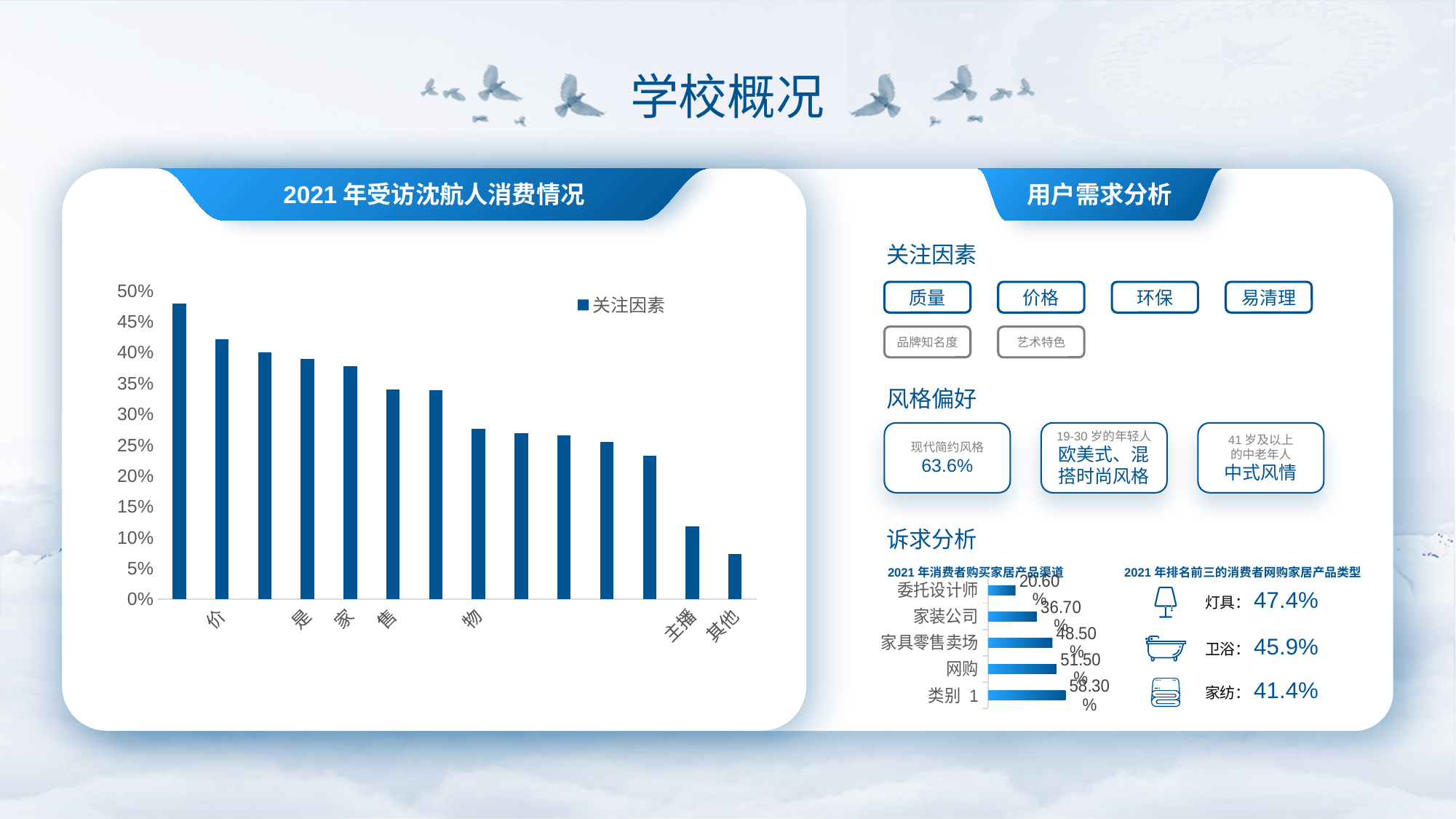
In the chart titled 2021 年受访沈航人消费情况, which is larger, the value for 主播 or the value for 其他? 主播 In the chart titled 2021 年受访沈航人消费情况, which category has the lowest value? 其他 How many series does the legend of the chart titled 2021 年受访沈航人消费情况 list? 1 In the chart titled 2021 年受访沈航人消费情况, do the bar values rise or fall from left to right? fall What is the legend entry shown in the chart titled 2021 年受访沈航人消费情况? 关注因素 In the chart titled 2021 年受访沈航人消费情况, is the value for 其他 greater or less than 10%? less How many bars are plotted in the chart titled 2021 年受访沈航人消费情况? 14 In the chart titled 2021 年受访沈航人消费情况, is the value for 主播 greater or less than 15%? less In the chart titled 2021 年消费者购买家居产品渠道, what is the difference between the values for 网购 and 家装公司? 14.80% What kind of chart is the chart titled 2021 年受访沈航人消费情况? bar chart In the chart titled 2021 年消费者购买家居产品渠道, which category has the highest value? 类别 1 In the chart titled 2021 年消费者购买家居产品渠道, what is the value for 网购? 51.50%